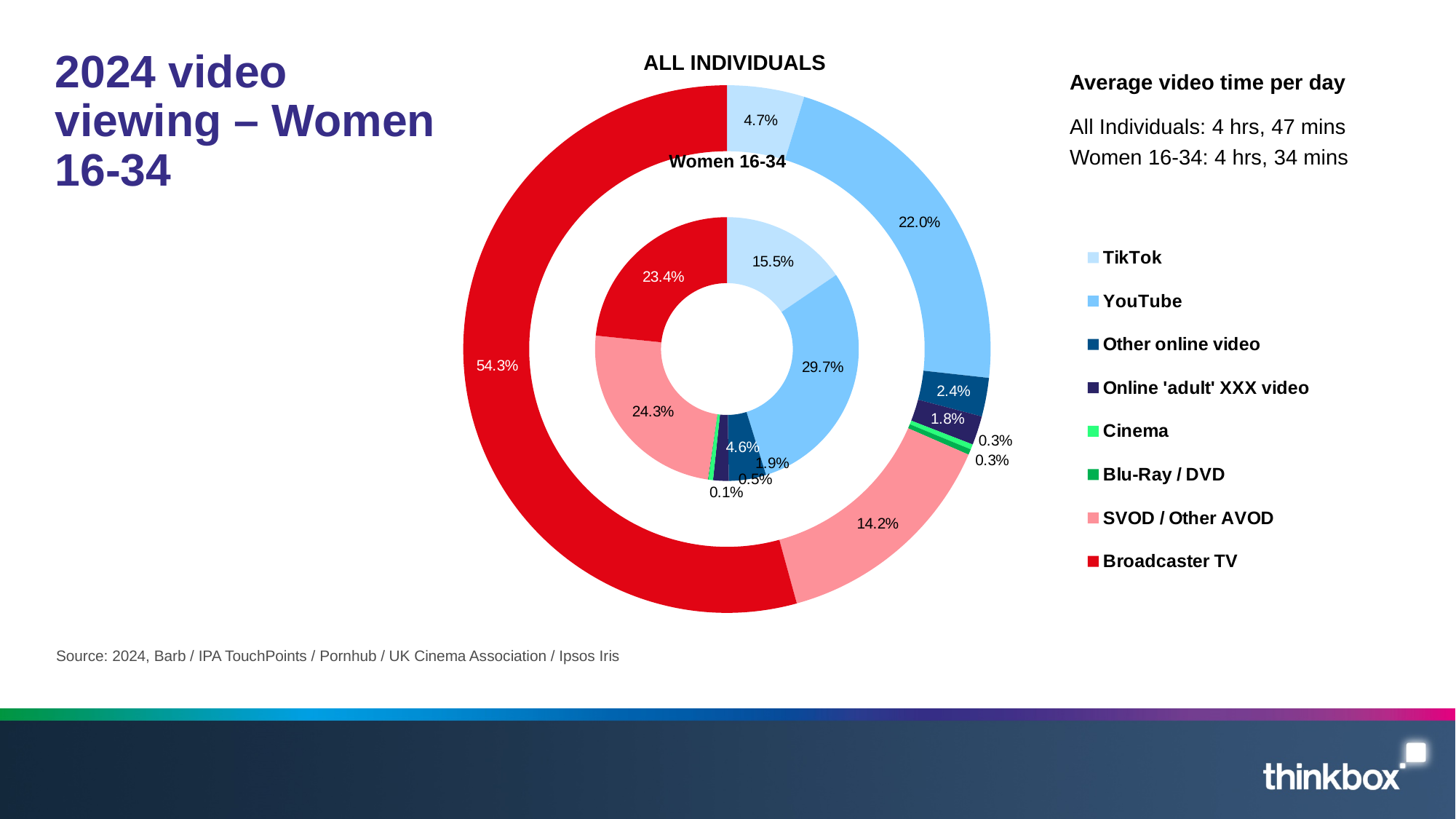
What share of video viewing does Broadcaster TV account for among All Individuals (outer ring)? 54.3% What is the TikTok share for Women 16-34 (inner ring)? 15.5% For Women 16-34, which is larger: the SVOD / Other AVOD share or the Broadcaster TV share? SVOD / Other AVOD How many categories does the legend list? 8 Which category has the largest share in the All Individuals ring? Broadcaster TV What is the difference between the TikTok share for Women 16-34 and for All Individuals? 10.8 percentage points What is the difference between the Broadcaster TV share for All Individuals and for Women 16-34? 30.9 percentage points What is the SVOD / Other AVOD share for All Individuals (outer ring)? 14.2% Which category has the largest share in the Women 16-34 ring? YouTube Which colour represents Broadcaster TV in the chart? Red What share of video viewing does YouTube account for among Women 16-34 (inner ring)? 29.7% What type of chart is shown on the slide? Doughnut chart